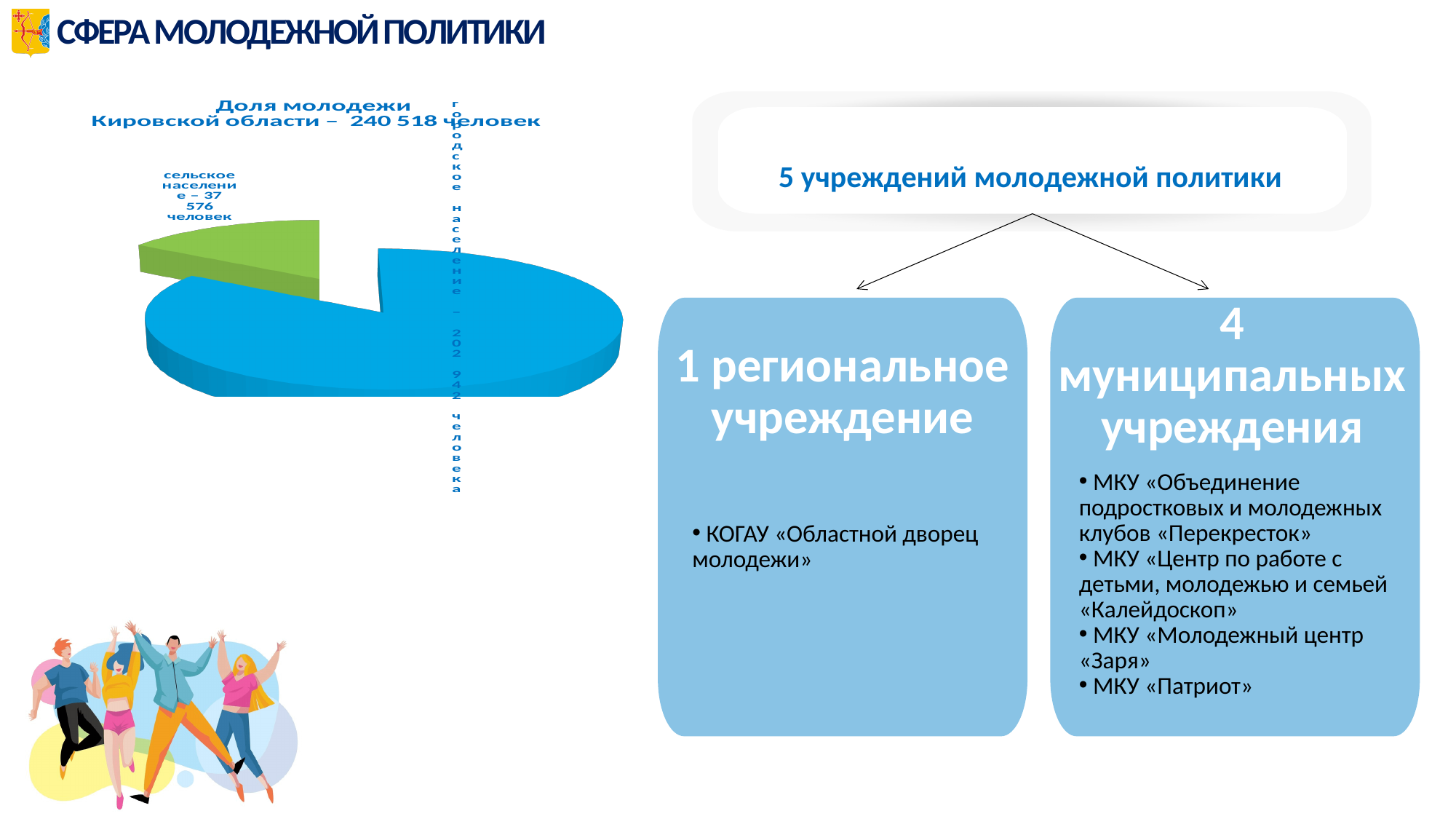
How many slices does the pie chart have? 2 What colour is the сельское население slice in the pie chart? Green Which is larger in the pie chart: городское население or сельское население? городское население What is the total of the two slices in the pie chart? 240 518 What is the title of the pie chart? Доля молодежи Кировской области – 240 518 человек In the pie chart, how many people are in the городское население category? 202 942 человека Which slice of the pie chart is the smallest? сельское население What is the difference between городское население and сельское население in the pie chart? 165 366 What type of chart is shown on the left of the slide? Pie chart In the pie chart, how many people are in the сельское население category? 37 576 человек Which slice of the pie chart is the largest? городское население